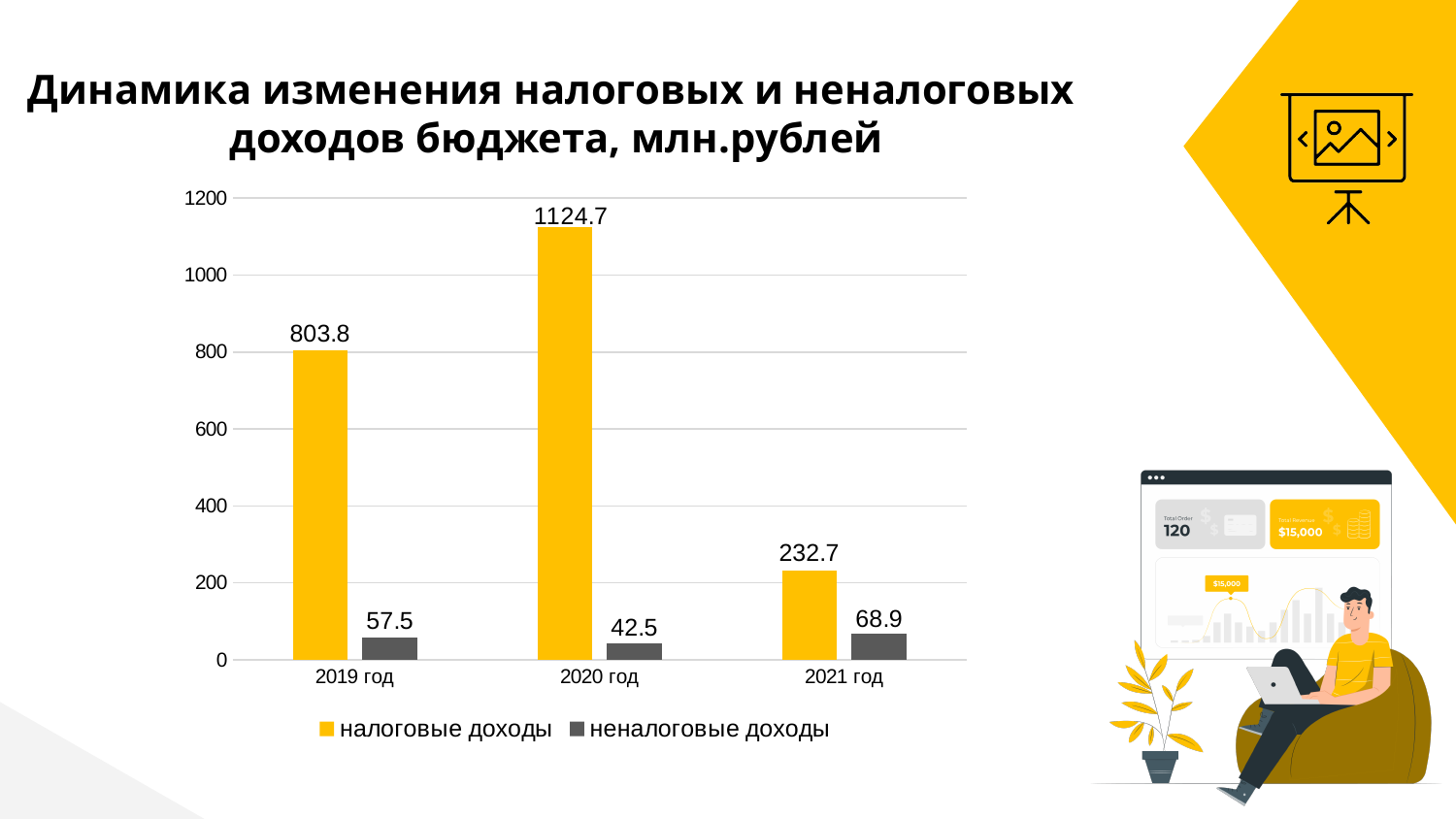
What is the value of налоговые доходы for 2019 год? 803.8 Which year has the highest value for налоговые доходы? 2020 год What is the difference between неналоговые доходы in 2021 год and 2019 год? 11.4 Is the value for налоговые доходы in 2021 год greater or less than 400? less Which year has the lowest value for неналоговые доходы? 2020 год How many years are shown on the x axis? 3 What is the value of неналоговые доходы for 2021 год? 68.9 How many series does the legend list? 2 Which is larger: неналоговые доходы in 2019 год or in 2021 год? 2021 год What is the value of налоговые доходы for 2020 год? 1124.7 What is the difference between налоговые доходы in 2020 год and 2021 год? 892 What kind of chart is shown on the slide? bar chart